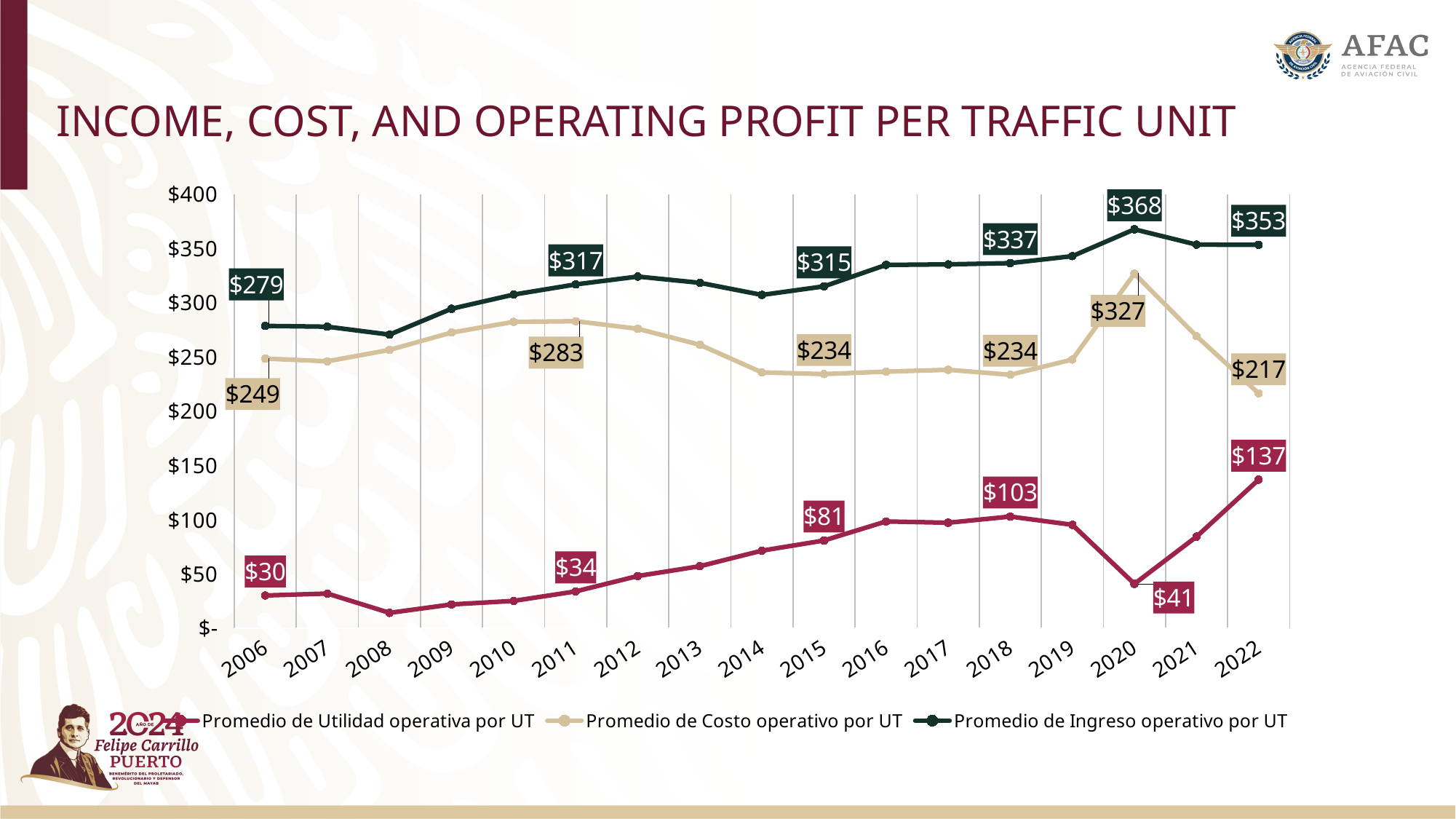
How many years are shown on the x axis of the chart? 17 Which year has the higher Promedio de Costo operativo por UT, 2011 or 2020? 2020 What is the value of Promedio de Costo operativo por UT in 2022? $217 What is the value of Promedio de Ingreso operativo por UT in 2020? $368 In which year is Promedio de Ingreso operativo por UT at its highest? 2020 Is the value of Promedio de Ingreso operativo por UT in 2008 greater or less than $300? less Is the value of Promedio de Utilidad operativa por UT in 2016 greater or less than $50? greater What is the difference between Promedio de Ingreso operativo por UT in 2020 and in 2022? $15 By how much did Promedio de Utilidad operativa por UT increase from 2020 to 2022? $96 What kind of chart is shown on the slide? line chart How many series does the legend list? 3 What is the value of Promedio de Utilidad operativa por UT in 2018? $103